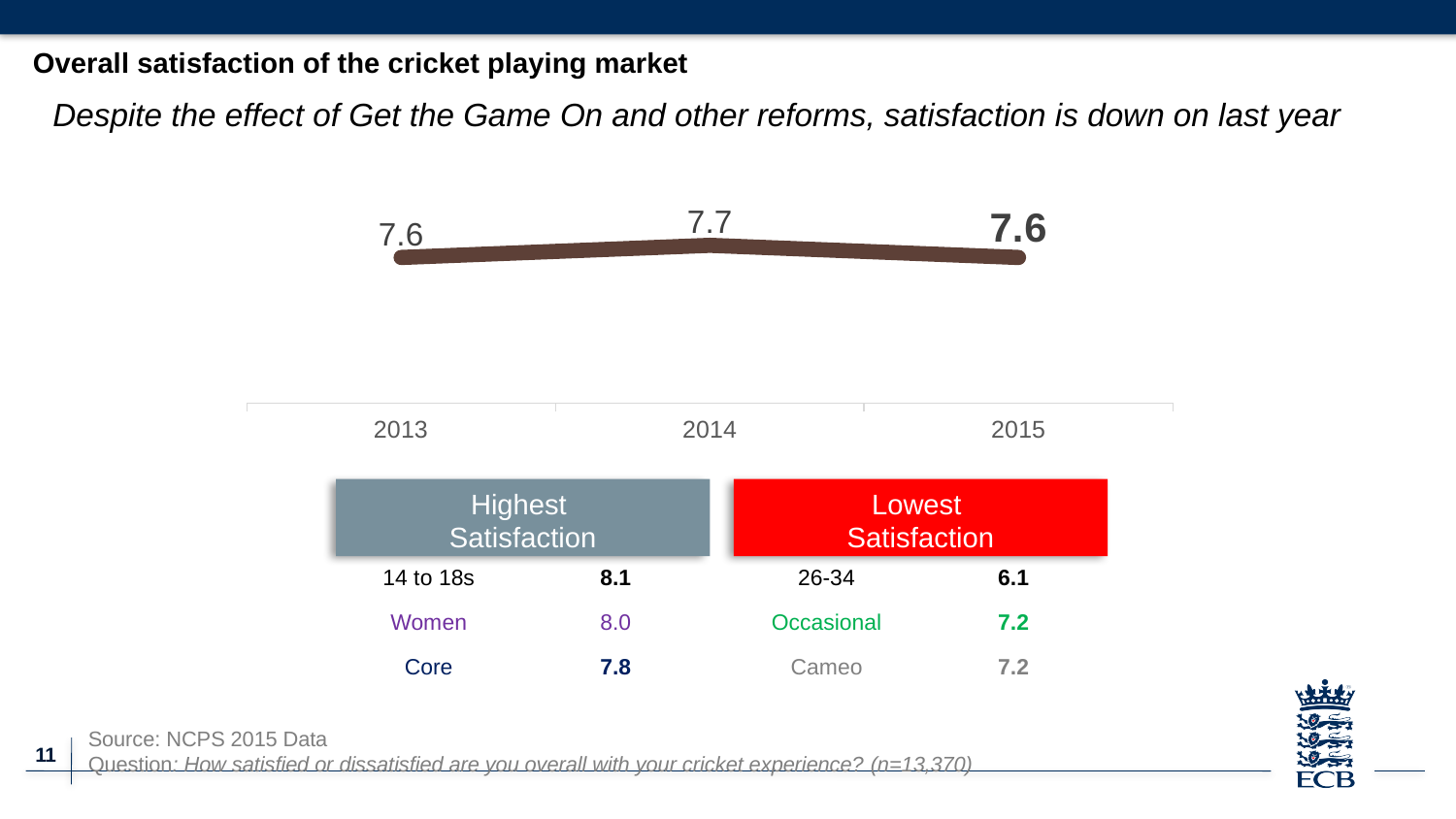
Which year has the highest overall satisfaction value? 2014 Does overall satisfaction rise or fall from 2013 to 2014? rise Is the satisfaction value for 2014 larger or smaller than the value for 2015? larger What is the difference between the 2014 and 2015 satisfaction values? 0.1 What kind of chart shows the overall satisfaction over 2013 to 2015? line chart What is the title of the slide containing the line chart? Overall satisfaction of the cricket playing market What is the overall satisfaction value for 2015? 7.6 How many years are plotted on the line chart? 3 What is the overall satisfaction value for 2014? 7.7 Does overall satisfaction rise or fall from 2014 to 2015? fall Which year's data label is shown in bold on the line chart? 2015 What is the overall satisfaction value for 2013? 7.6